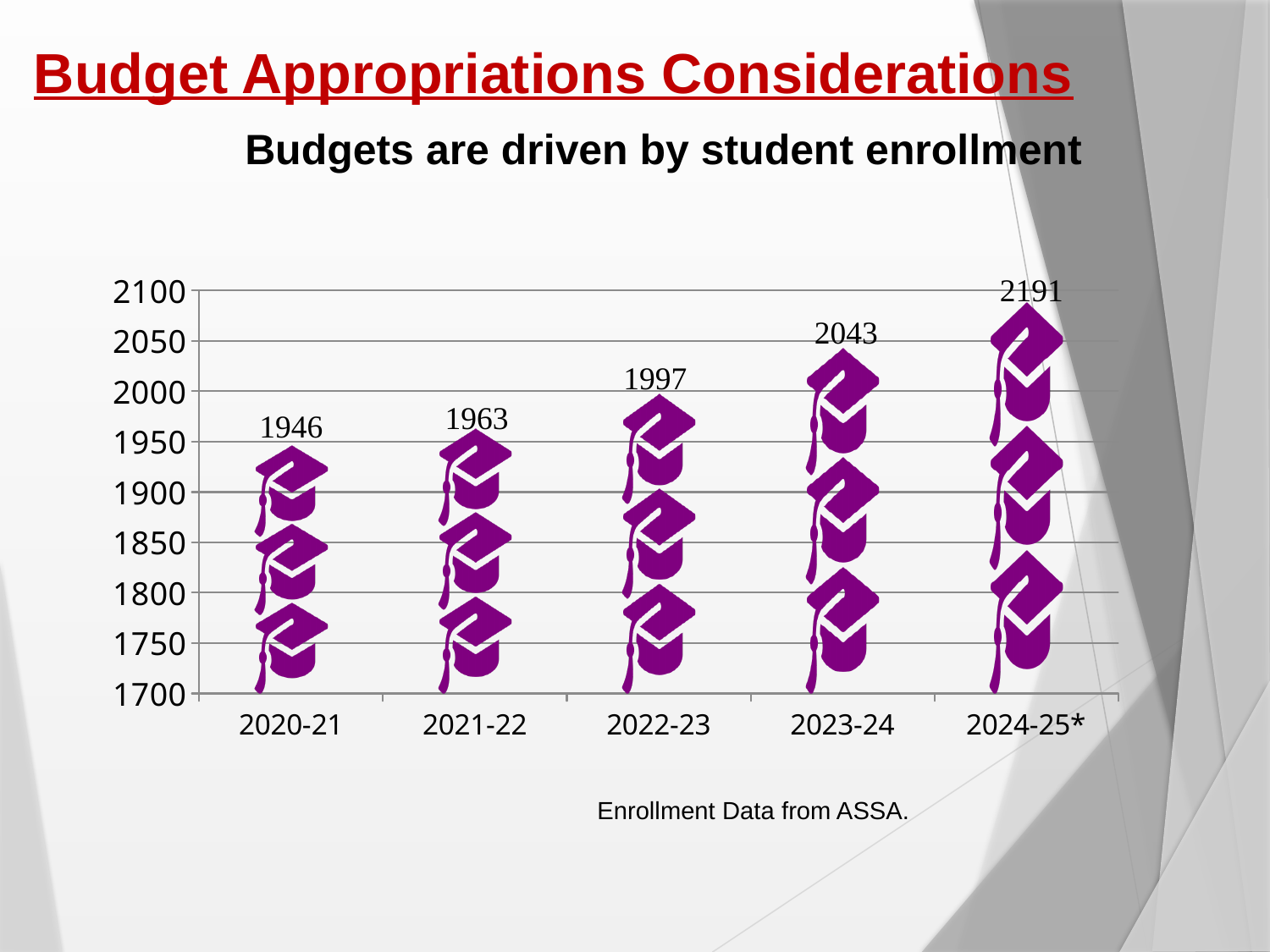
Which year has the highest enrollment? 2024-25* What is the enrollment value for 2020-21? 1946 What is the enrollment value for 2024-25*? 2191 What is the difference in enrollment between 2024-25* and 2023-24? 148 How many years are shown on the x axis? 5 Which is larger, the enrollment for 2023-24 or for 2022-23? 2023-24 What kind of chart is shown on the slide? bar chart Do the enrollment values rise or fall from 2020-21 to 2024-25*? rise What is the difference in enrollment between 2021-22 and 2020-21? 17 Is the enrollment value for 2023-24 greater or less than 2000? greater Which year has the lowest enrollment? 2020-21 What is the enrollment value for 2022-23? 1997